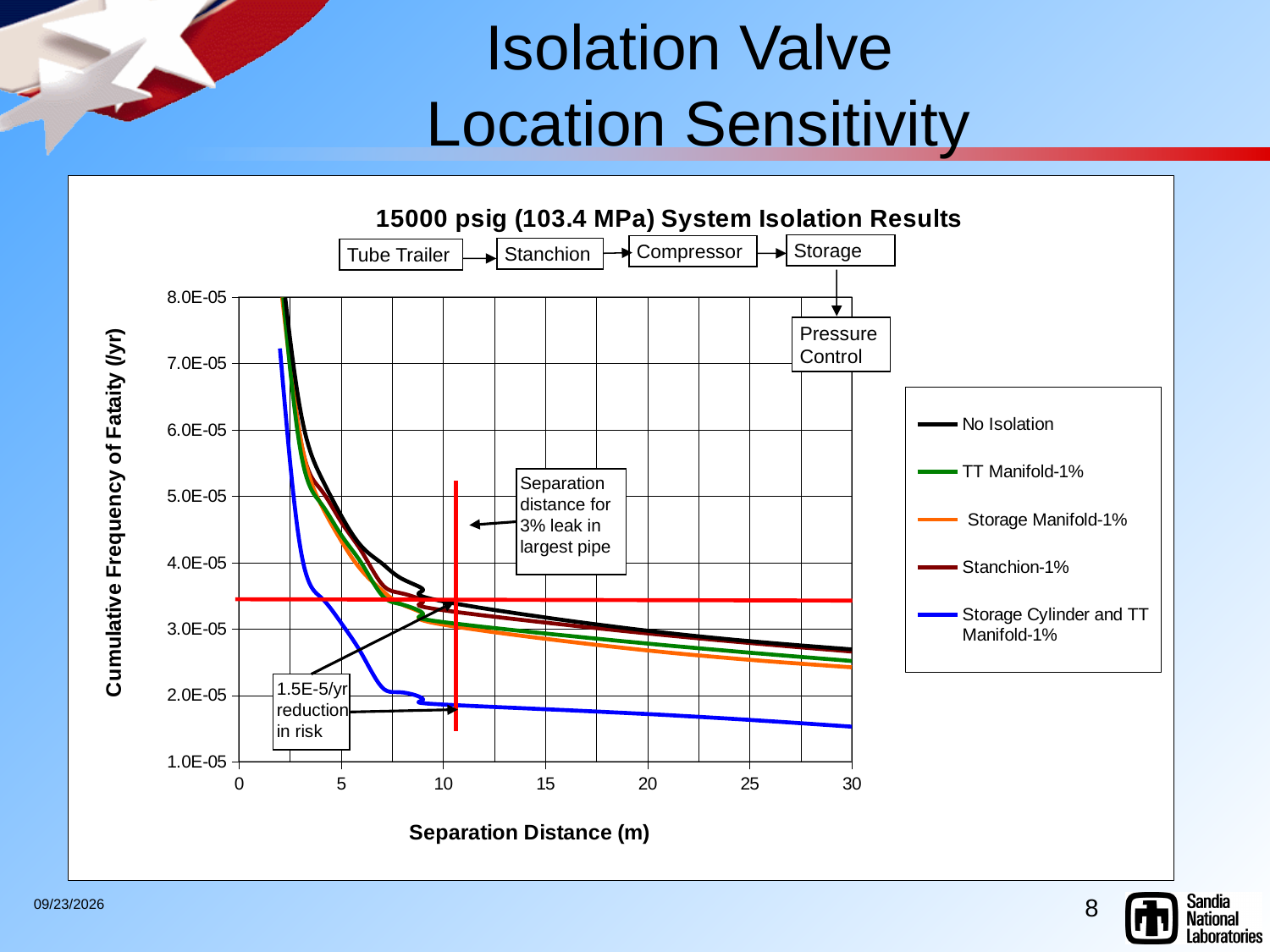
At a separation distance of 30 m, which is larger: the value for No Isolation or the value for Storage Manifold-1%? No Isolation At a separation distance of 30 m, which is larger: the value for No Isolation or the value for Storage Cylinder and TT Manifold-1%? No Isolation What is the label of the x axis? Separation Distance (m) At a separation distance of 30 m, is the value for Storage Cylinder and TT Manifold-1% greater or less than 2.0E-05? less What is the title of the chart? 15000 psig (103.4 MPa) System Isolation Results How many series does the legend list? 5 Which series has the lowest cumulative frequency of fatality at a separation distance of 30 m? Storage Cylinder and TT Manifold-1% Do the plotted values rise or fall as separation distance increases? Fall At a separation distance of 30 m, is the value for No Isolation greater or less than 3.0E-05? less What kind of chart is shown on the slide? Line chart At a separation distance of 15 m, is the value for No Isolation greater or less than 3.0E-05? greater